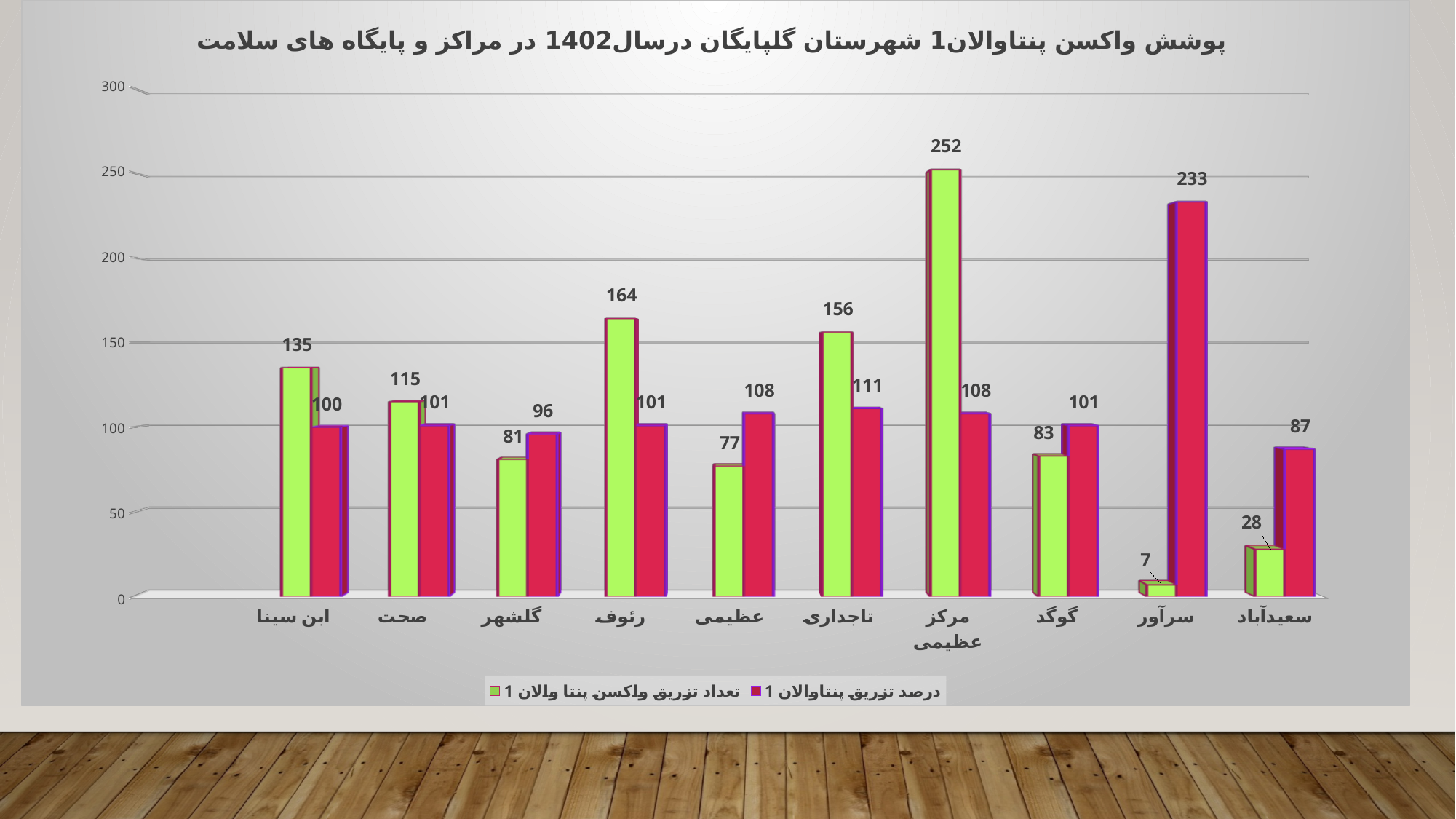
What is the difference between the green series values for مرکز عظیمی and تاجداری? 96 What is the value of the red series (درصد تزریق پنتاوالان 1) for سعیدآباد? 87 What is the value of the green series (تعداد تزریق واکسن پنتا والان 1) for مرکز عظیمی? 252 What is the value of the green series (تعداد تزریق واکسن پنتا والان 1) for رئوف? 164 What kind of chart is shown on the slide? bar chart How many series does the legend list? 2 Which category has the highest value in the green series (تعداد تزریق واکسن پنتا والان 1)? مرکز عظیمی Which category has the highest value in the red series (درصد تزریق پنتاوالان 1)? سرآور How many categories are shown on the x axis? 10 What is the value of the red series (درصد تزریق پنتاوالان 1) for سرآور? 233 For گلشهر, which series has the larger value, the green (تعداد تزریق) or the red (درصد تزریق)? red (درصد تزریق پنتاوالان 1) Which category has the lowest value in the green series (تعداد تزریق واکسن پنتا والان 1)? سرآور